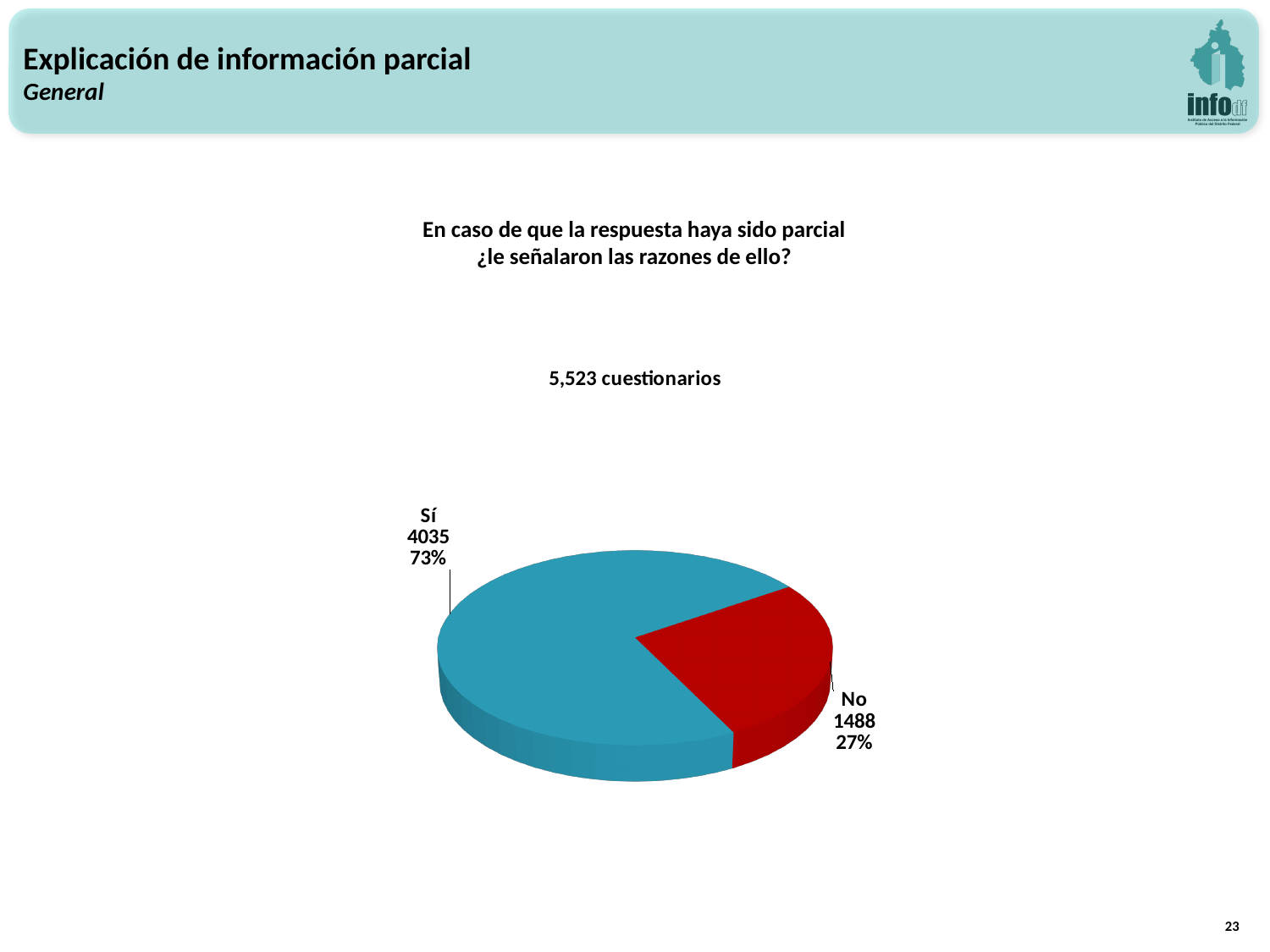
What percentage share does the "Sí" slice represent? 73% How many slices does the pie chart have? 2 What percentage share does the "No" slice represent? 27% How many questionnaires does the slide say the chart is based on? 5,523 cuestionarios Which slice is the smallest? No What is the value for the "Sí" slice? 4035 What is the difference between the "Sí" and "No" values? 2547 Which slice is the largest? Sí What is the value for the "No" slice? 1488 Which is larger, the "Sí" slice or the "No" slice? Sí What colour is the "No" slice? red What kind of chart is shown on the slide? pie chart